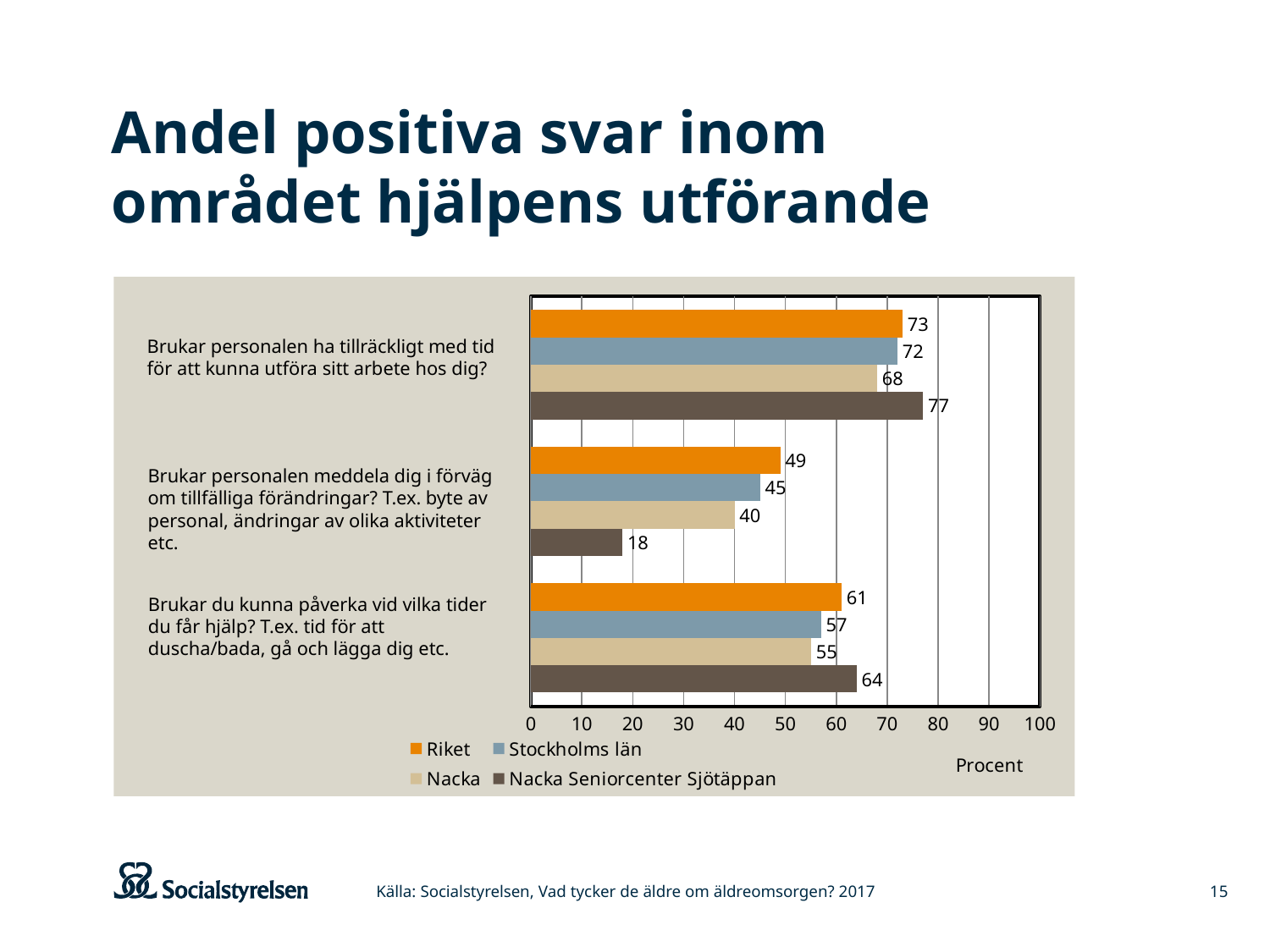
How many questions (categories) are shown in the chart? 3 Which series has the lowest value on the question "Brukar personalen meddela dig i förväg om tillfälliga förändringar?"? Nacka Seniorcenter Sjötäppan Which is larger on the question "Brukar personalen meddela dig i förväg om tillfälliga förändringar?": Riket or Nacka? Riket Is the value for Nacka Seniorcenter Sjötäppan on the question "Brukar personalen ha tillräckligt med tid" greater or less than 70? greater What is the value for Nacka Seniorcenter Sjötäppan on the question "Brukar personalen meddela dig i förväg om tillfälliga förändringar?"? 18 What is the difference between Riket and Nacka on the question "Brukar du kunna påverka vid vilka tider du får hjälp?"? 6 What is the label of the x axis? Procent What kind of chart is shown on the slide? Bar chart Which series has the highest value on the question "Brukar personalen ha tillräckligt med tid för att kunna utföra sitt arbete hos dig?"? Nacka Seniorcenter Sjötäppan What is the value for Riket on the question "Brukar personalen ha tillräckligt med tid för att kunna utföra sitt arbete hos dig?"? 73 How many series does the legend list? 4 What is the value for Stockholms län on the question "Brukar du kunna påverka vid vilka tider du får hjälp?"? 57